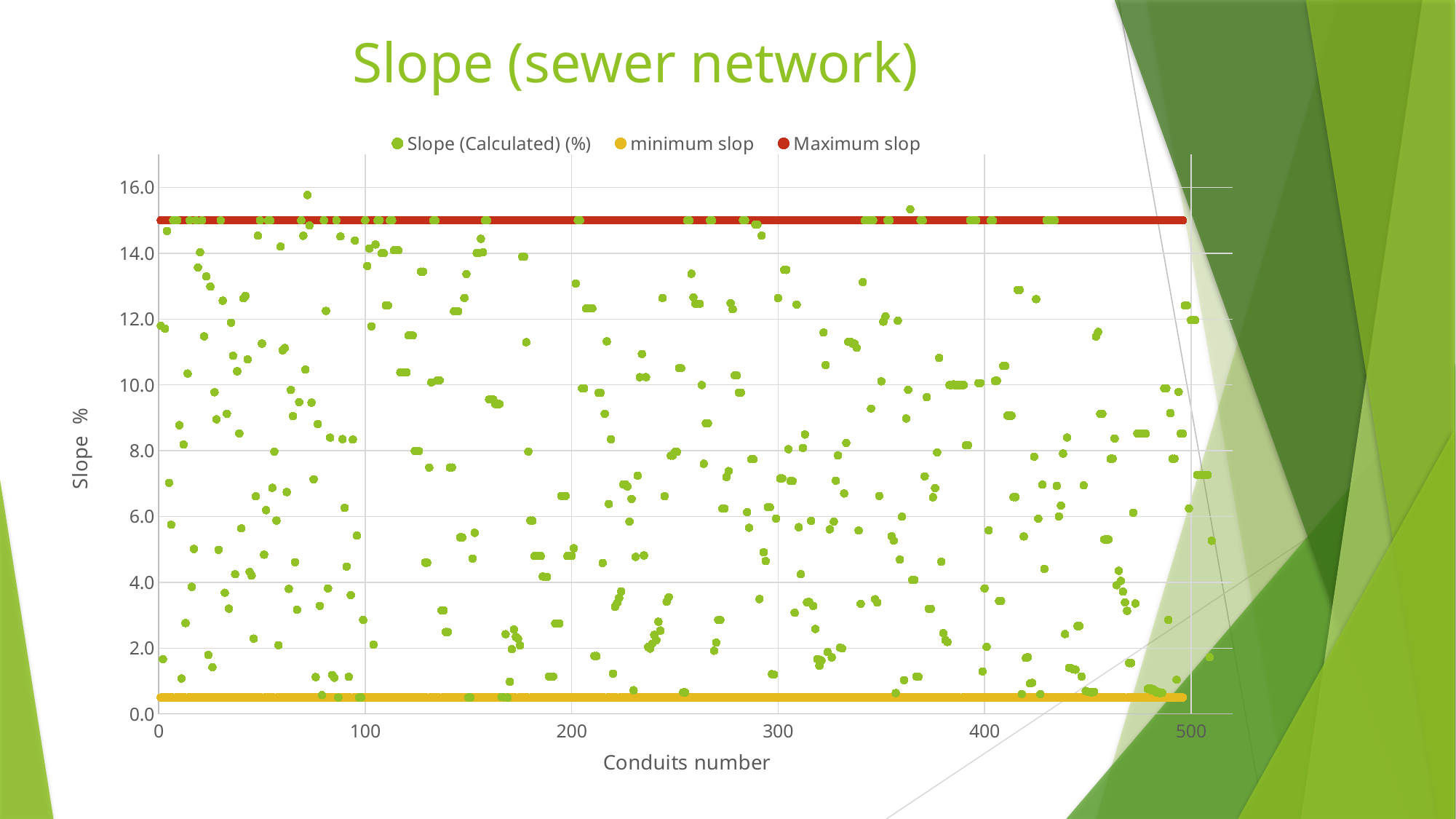
Is the Maximum slop line greater or less than 16.0? less Is the minimum slop line greater or less than 2.0? less Which series has the highest constant value on the chart? Maximum slop What is the label of the x axis? Conduits number What kind of chart is shown on the slide? scatter chart How many series does the legend list? 3 Which series has the lowest values on the chart? minimum slop Is the highest Slope (Calculated) (%) point greater or less than 14.0? greater Which series is plotted higher on the chart, minimum slop or Maximum slop? Maximum slop What is the title of the chart? Slope (sewer network)